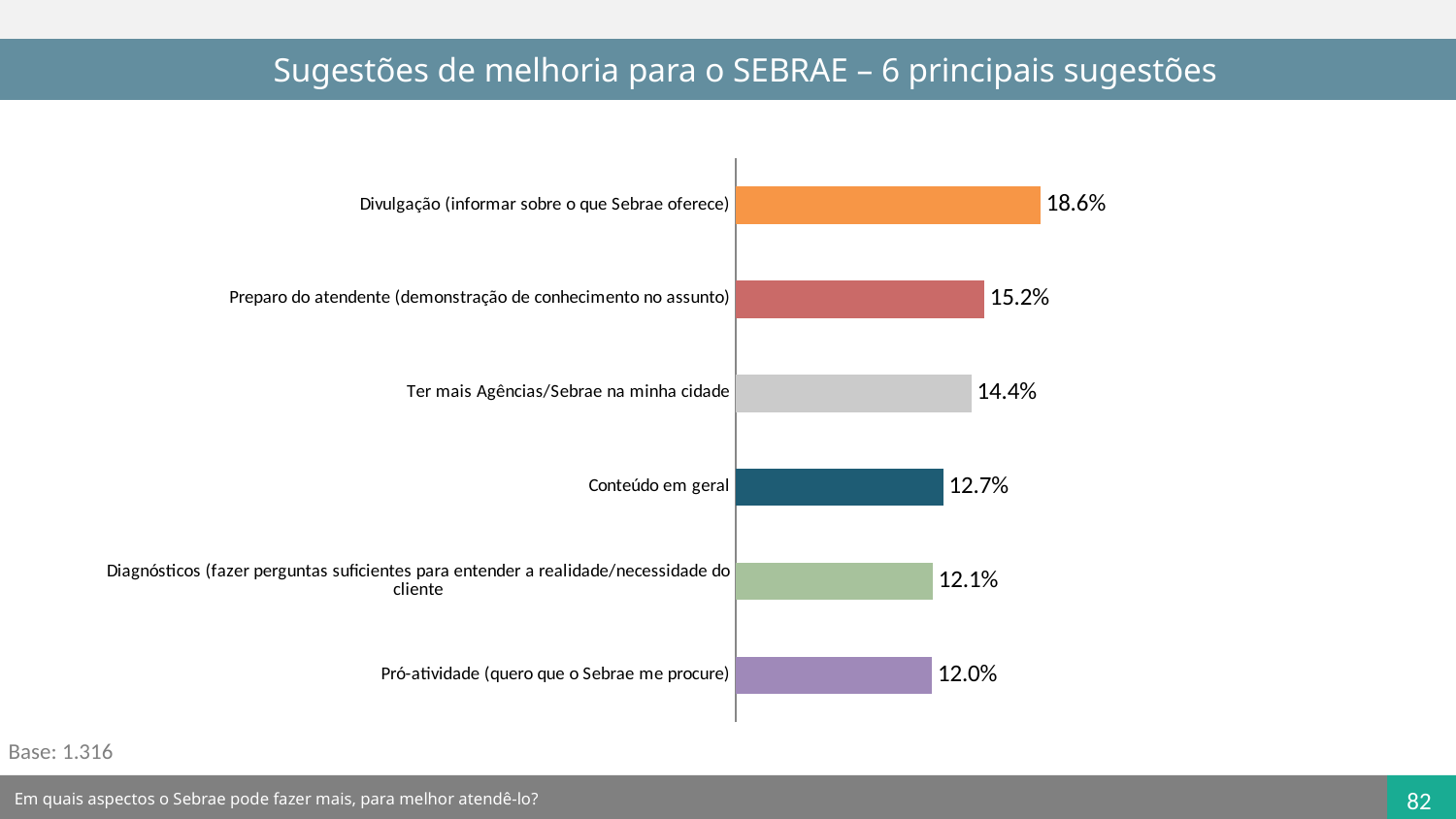
What is the difference between the values for "Divulgação (informar sobre o que Sebrae oferece)" and "Preparo do atendente (demonstração de conhecimento no assunto)"? 3.4% What is the title of the slide? Sugestões de melhoria para o SEBRAE – 6 principais sugestões How many categories are shown in the chart? 6 What is the difference between the values for "Ter mais Agências/Sebrae na minha cidade" and "Conteúdo em geral"? 1.7% What is the value for "Ter mais Agências/Sebrae na minha cidade"? 14.4% What kind of chart is shown on the slide? Bar chart Which category has the lowest value? Pró-atividade (quero que o Sebrae me procure) What is the base (number of respondents) shown on the slide? 1.316 What is the value for "Divulgação (informar sobre o que Sebrae oferece)"? 18.6% What is the value for "Conteúdo em geral"? 12.7% Which category has the highest value? Divulgação (informar sobre o que Sebrae oferece) Which is larger: the value for "Preparo do atendente (demonstração de conhecimento no assunto)" or the value for "Conteúdo em geral"? Preparo do atendente (demonstração de conhecimento no assunto)